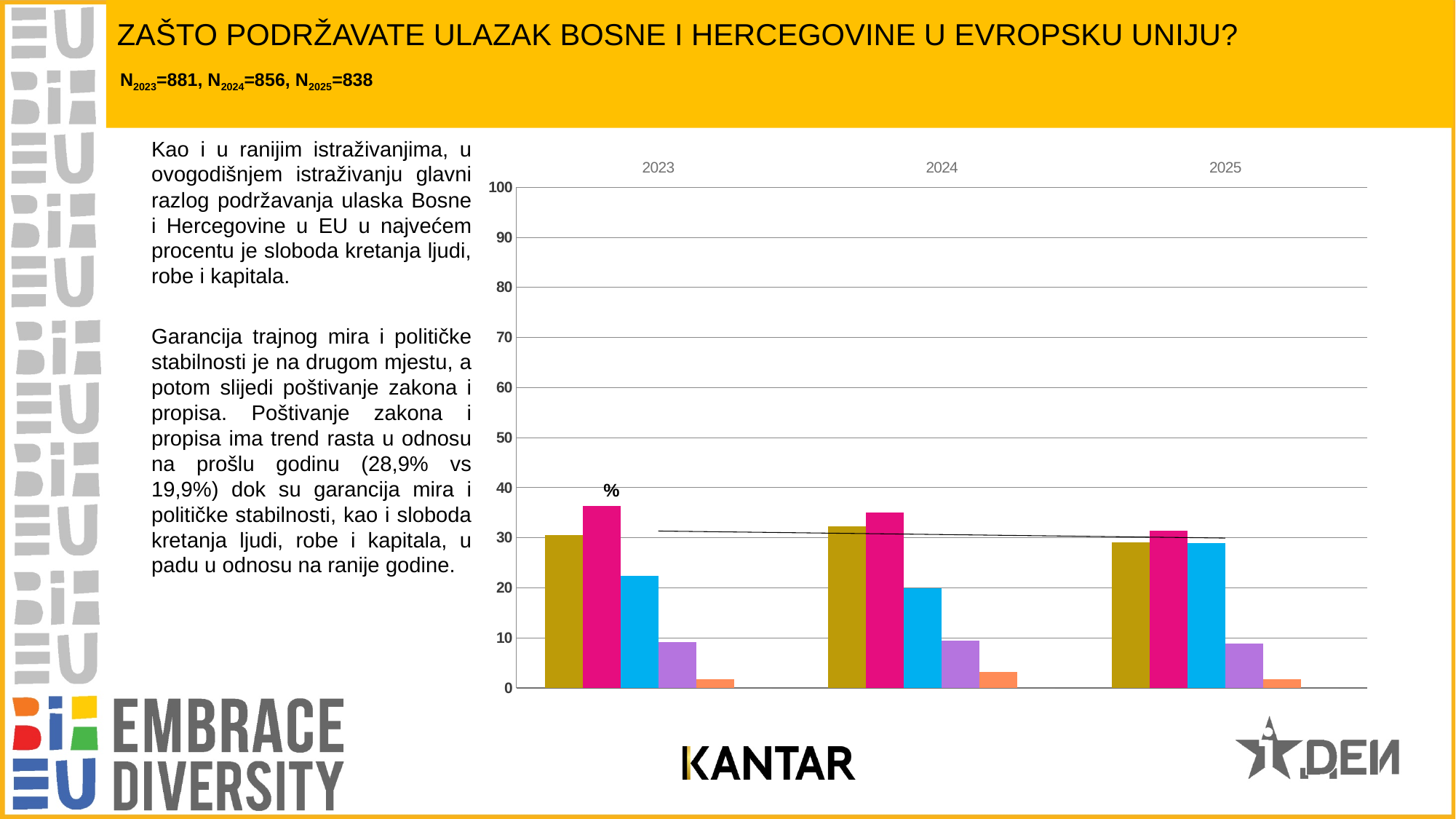
What is the highest value shown on the y axis of the chart? 100 In the 2023 group, which coloured bar is the tallest? the magenta bar Is the value of the orange bar for 2025 greater or less than 10? less What kind of chart is shown on the slide? bar chart Which years are labelled along the x axis of the chart? 2023, 2024, 2025 Is the value of the magenta bar for 2023 greater or less than 30? greater Does the magenta bar rise or fall from 2023 to 2025? fall In the 2024 group, which coloured bar is the shortest? the orange bar Is the value of the blue bar for 2024 greater or less than 30? less In the 2023 group, which is larger: the magenta bar or the blue bar? the magenta bar How many bars are plotted in each year group of the chart? 5 How many year groups are shown along the x axis of the chart? 3